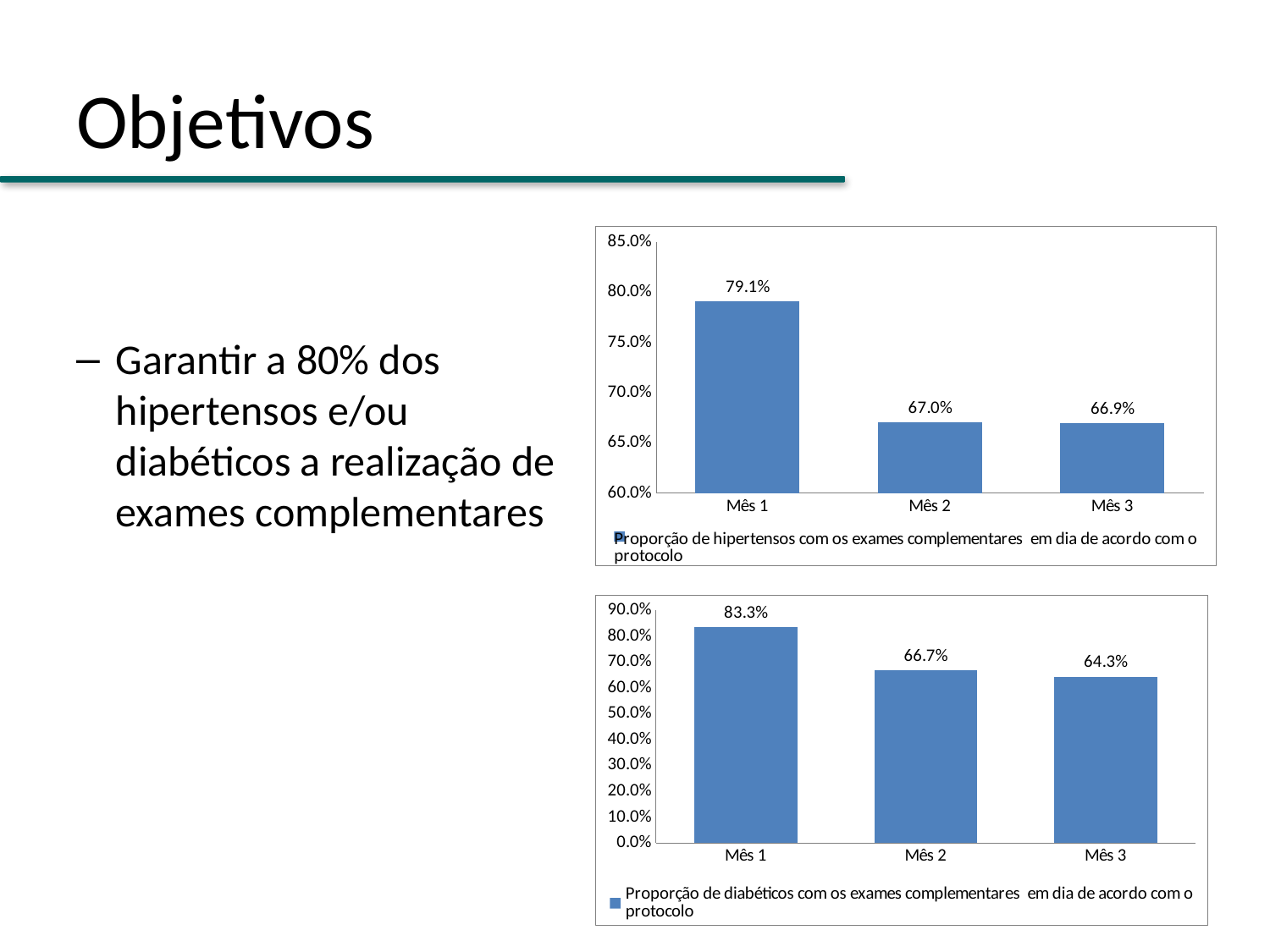
In the bottom chart (diabéticos), what is the difference between the values for Mês 1 and Mês 3? 19.0% In the bottom chart (diabéticos), which month has the lowest value? Mês 3 In the top chart (hipertensos), is the value for Mês 1 greater or less than 75.0%? greater In the bottom chart (diabéticos), do the values rise or fall from Mês 1 to Mês 3? Fall In the top chart (hipertensos), what is the value for Mês 1? 79.1% In the top chart (hipertensos), what is the value for Mês 3? 66.9% In the top chart (hipertensos), what is the difference between the values for Mês 1 and Mês 2? 12.1% How many months are shown on the x axis of the bottom chart (diabéticos)? 3 How many series does the legend of the top chart list? 1 What kind of chart is the top chart (hipertensos)? Bar chart In the bottom chart (diabéticos), what is the value for Mês 2? 66.7% In the bottom chart (diabéticos), which month has the highest value? Mês 1